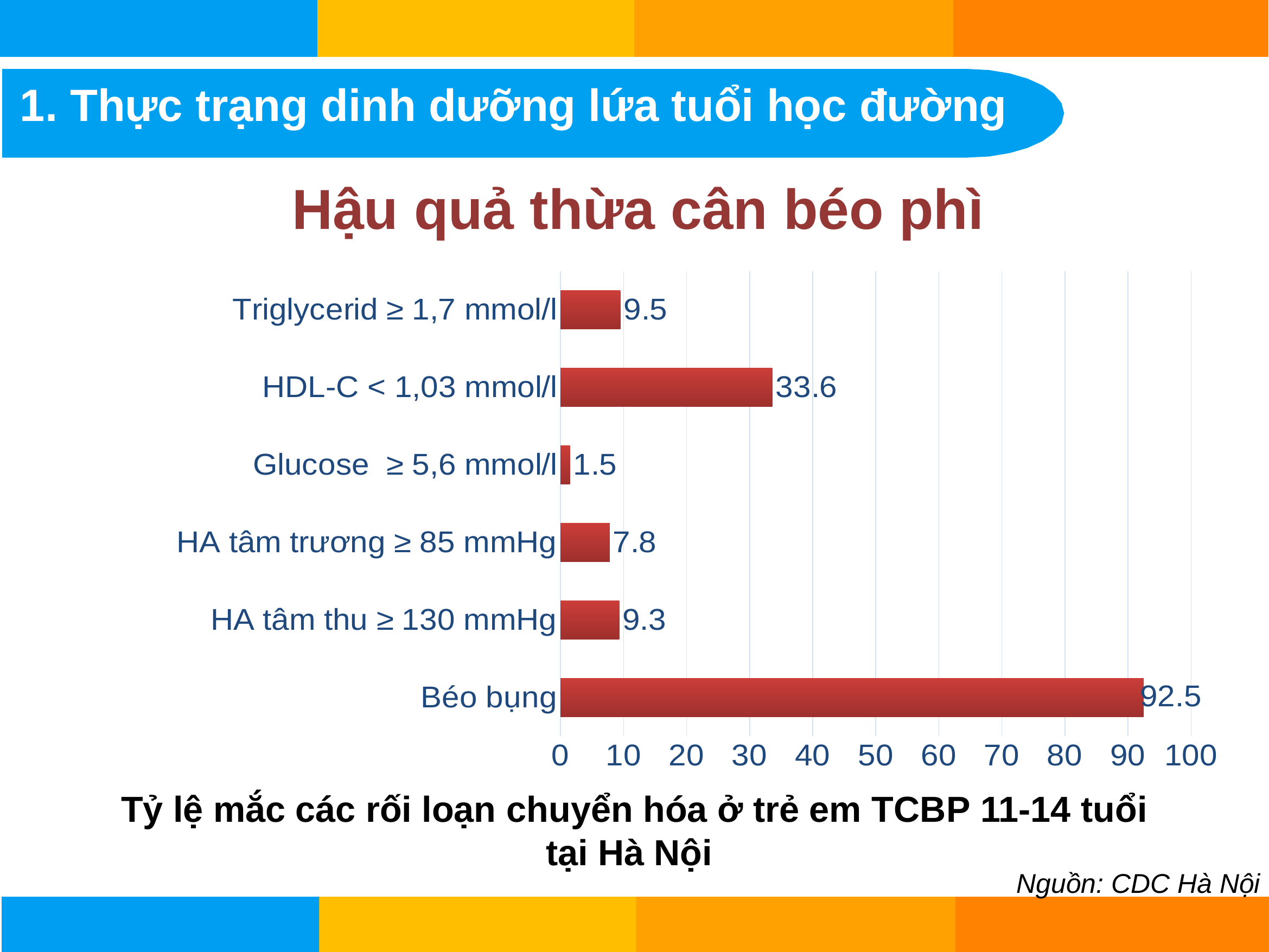
What kind of chart is shown on the slide? bar chart How many categories are shown in the chart? 6 Which is larger, the value for Triglycerid ≥ 1,7 mmol/l or the value for HA tâm trương ≥ 85 mmHg? Triglycerid ≥ 1,7 mmol/l Is the value for HDL-C < 1,03 mmol/l greater or less than 30? greater What is the source cited for the chart? CDC Hà Nội What is the value for Glucose ≥ 5,6 mmol/l? 1.5 What is the value for Béo bụng? 92.5 What is the value for HA tâm trương ≥ 85 mmHg? 7.8 What is the value for HDL-C < 1,03 mmol/l? 33.6 Which category has the highest value? Béo bụng Which category has the lowest value? Glucose ≥ 5,6 mmol/l What is the difference between the values for Béo bụng and HDL-C < 1,03 mmol/l? 58.9